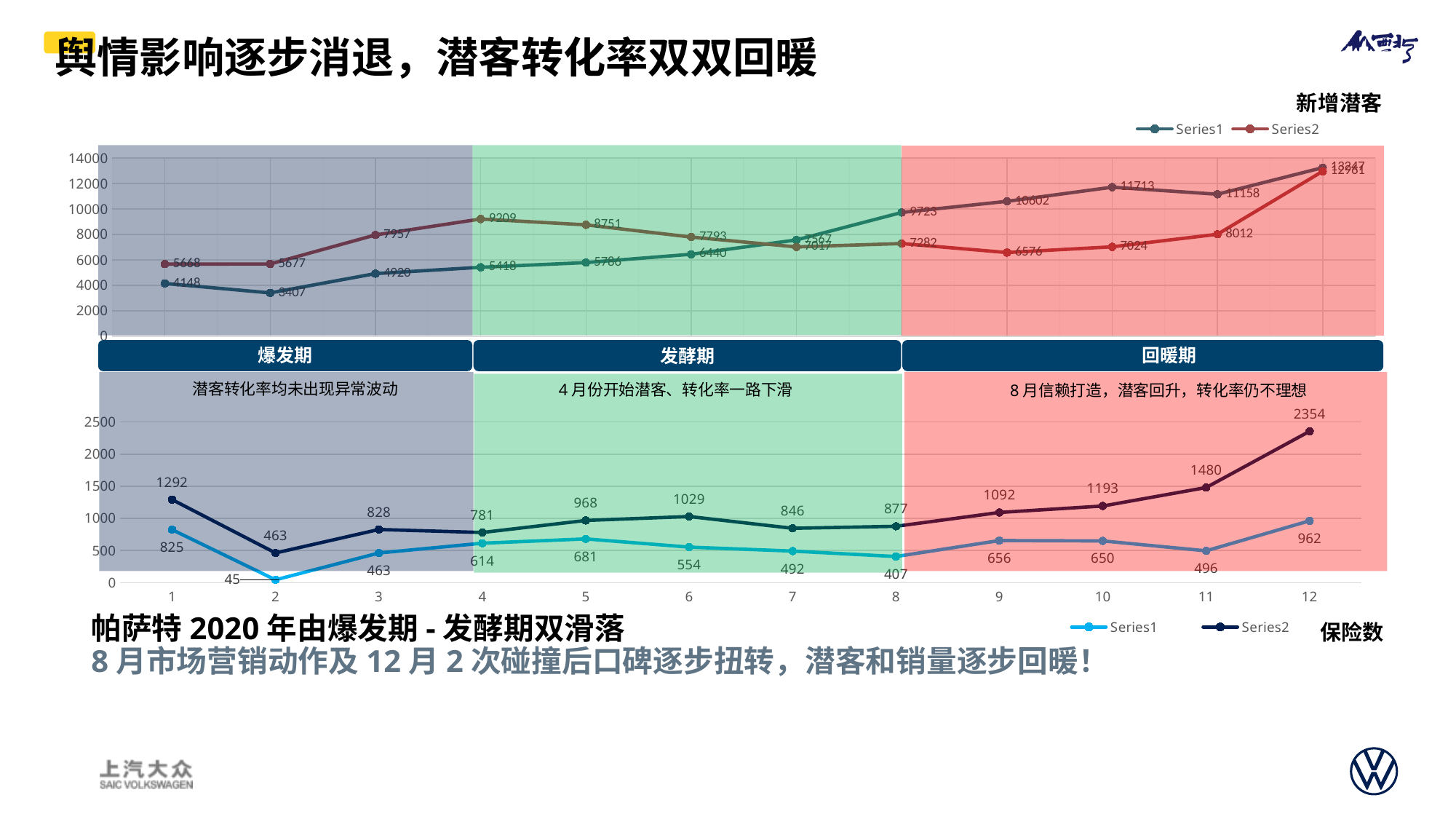
In the bottom chart (保险数), what is the value of Series1 at x = 2? 45 In the top chart (新增潜客), is the value of Series1 at the tenth point greater or less than 10000? greater What type of chart is the top chart (新增潜客)? Line chart In the bottom chart (保险数), at x = 1, which series has the larger value? Series2 In the bottom chart (保险数), what is the value of Series2 at x = 12? 2354 In the bottom chart (保险数), at which x value does Series2 reach its highest point? 12 In the bottom chart (保险数), at which x value is Series1 lowest? 2 In the top chart (新增潜客), what is the value of Series1 at the leftmost (first) point? 4148 In the top chart (新增潜客), what is the value of Series2 at the third point? 7957 In the bottom chart (保险数), how many data points does each series have? 12 In the bottom chart (保险数), what is the difference between Series2 and Series1 at x = 12? 1392 How many series does the legend of the top chart (新增潜客) list? 2